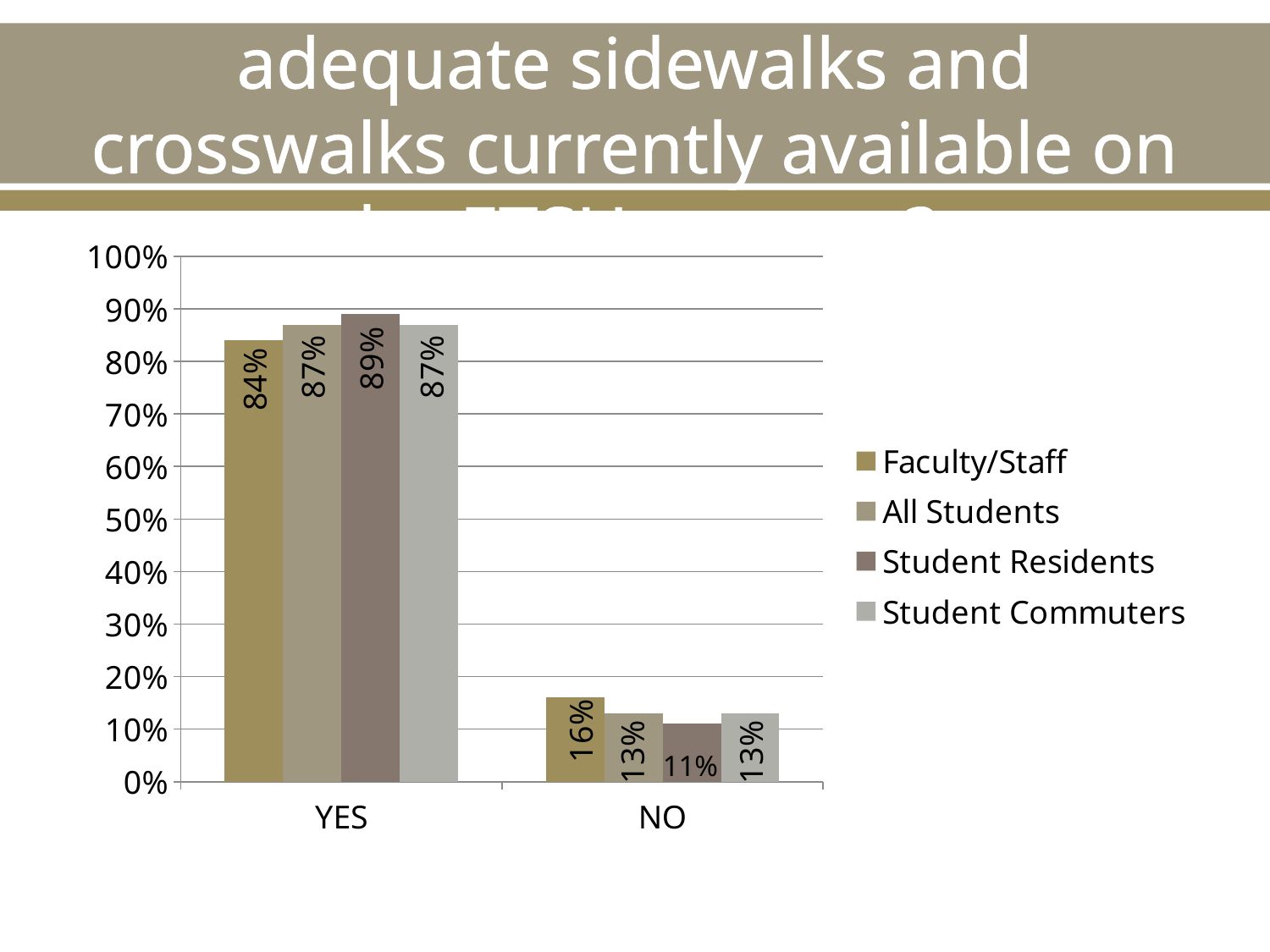
Which series has the lowest value in the NO category? Student Residents What is the value for Student Residents in the NO category? 11% What is the value for Student Commuters in the NO category? 13% Which series has the highest value in the YES category? Student Residents What is the difference between the Faculty/Staff values for YES and NO? 68% What is the value for Faculty/Staff in the YES category? 84% How many categories are shown on the x axis? 2 Which is larger: the Faculty/Staff value for NO or the All Students value for NO? Faculty/Staff Is the value for Student Residents in the YES category greater or less than 80%? greater What kind of chart is shown on the slide? bar chart What is the value for All Students in the YES category? 87% How many series does the legend list? 4